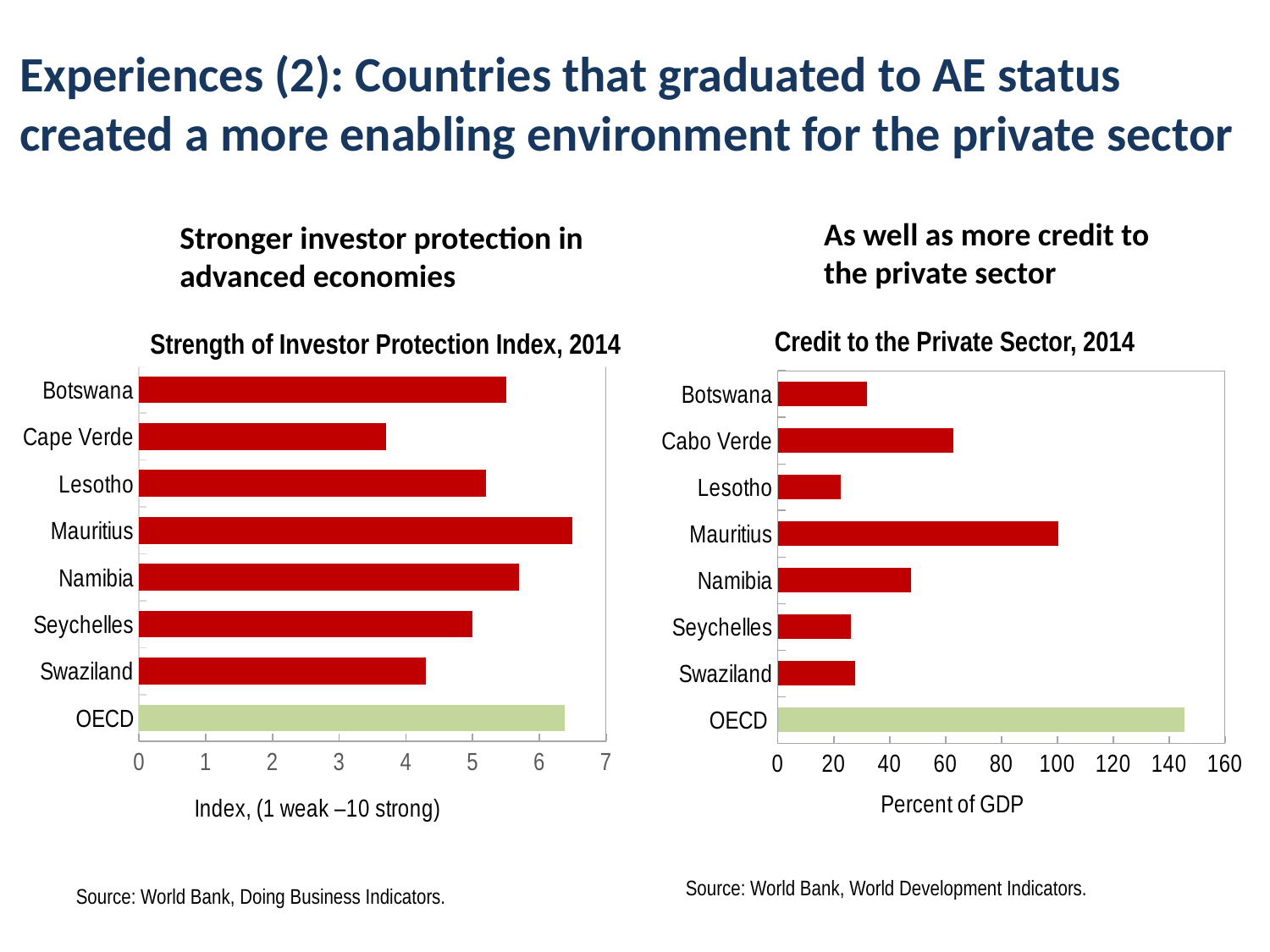
In the 'Strength of Investor Protection Index, 2014' chart, is the value for Cape Verde greater or less than 4? less In the 'Strength of Investor Protection Index, 2014' chart, which country has the lowest value? Cape Verde What is the x-axis label of the 'Credit to the Private Sector, 2014' chart? Percent of GDP In the 'Credit to the Private Sector, 2014' chart, which country has the lowest value? Lesotho In the 'Strength of Investor Protection Index, 2014' chart, which is larger, Botswana or Swaziland? Botswana In the 'Credit to the Private Sector, 2014' chart, is the value for OECD greater or less than 140? greater In the 'Strength of Investor Protection Index, 2014' chart, how many categories are shown? 8 In the 'Credit to the Private Sector, 2014' chart, which is larger, Mauritius or Namibia? Mauritius In the 'Credit to the Private Sector, 2014' chart, is the value for Cabo Verde greater or less than 60? greater In the 'Credit to the Private Sector, 2014' chart, which category has the highest value? OECD What kind of chart is the 'Strength of Investor Protection Index, 2014' chart? bar chart